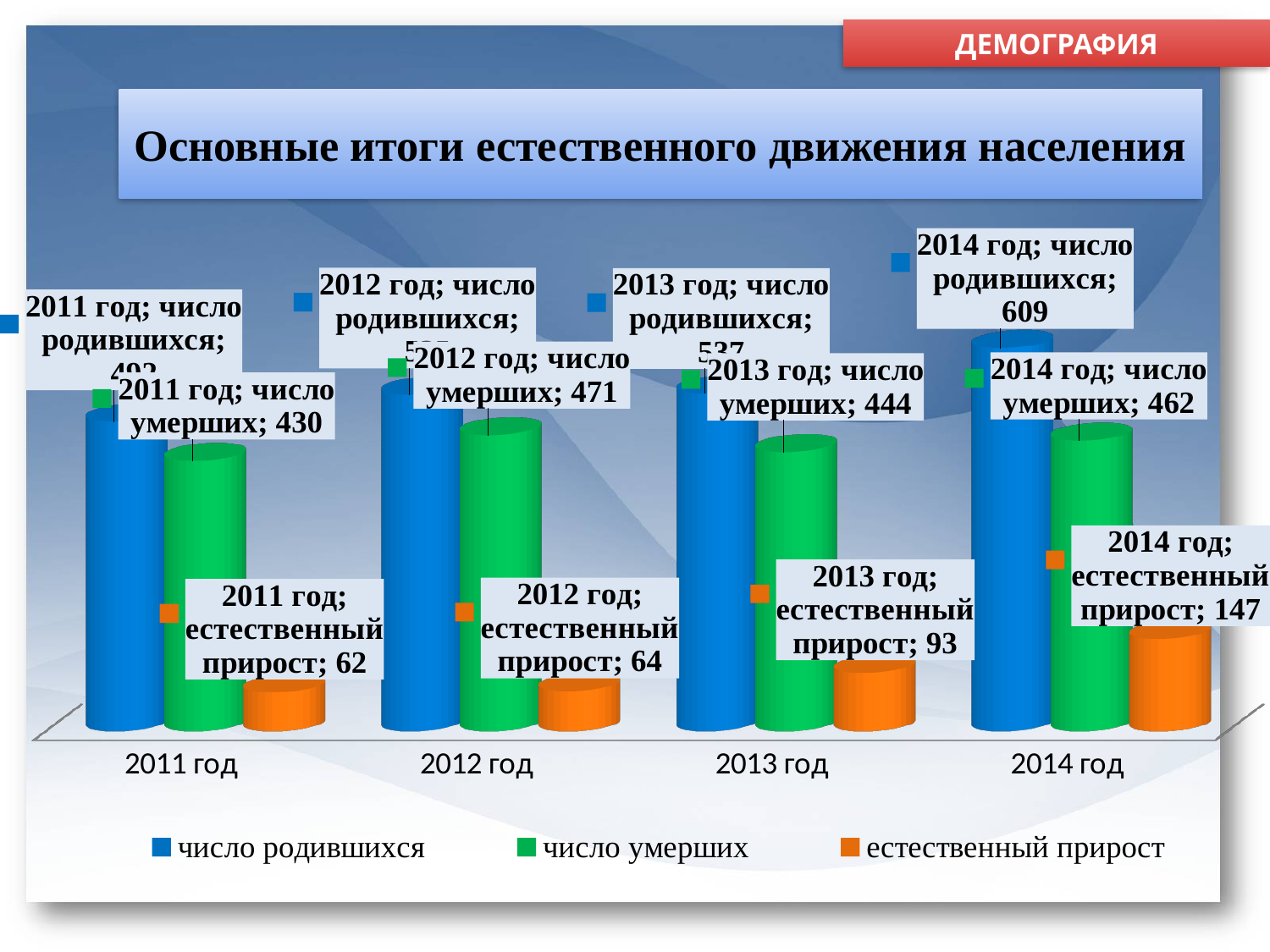
Does естественный прирост rise or fall from 2011 год to 2014 год? rise In which year is естественный прирост the lowest? 2011 год In which year is число умерших the highest? 2012 год What is the value for число умерших in 2011 год? 430 How many series does the legend list? 3 What kind of chart is shown on the slide? bar chart What is the value for число родившихся in 2014 год? 609 What is the difference between число умерших in 2012 год and in 2011 год? 41 Which is larger: число умерших in 2014 год or in 2013 год? 2014 год What is the difference between естественный прирост in 2014 год and in 2013 год? 54 What is the value for естественный прирост in 2013 год? 93 How many years are shown on the x axis? 4